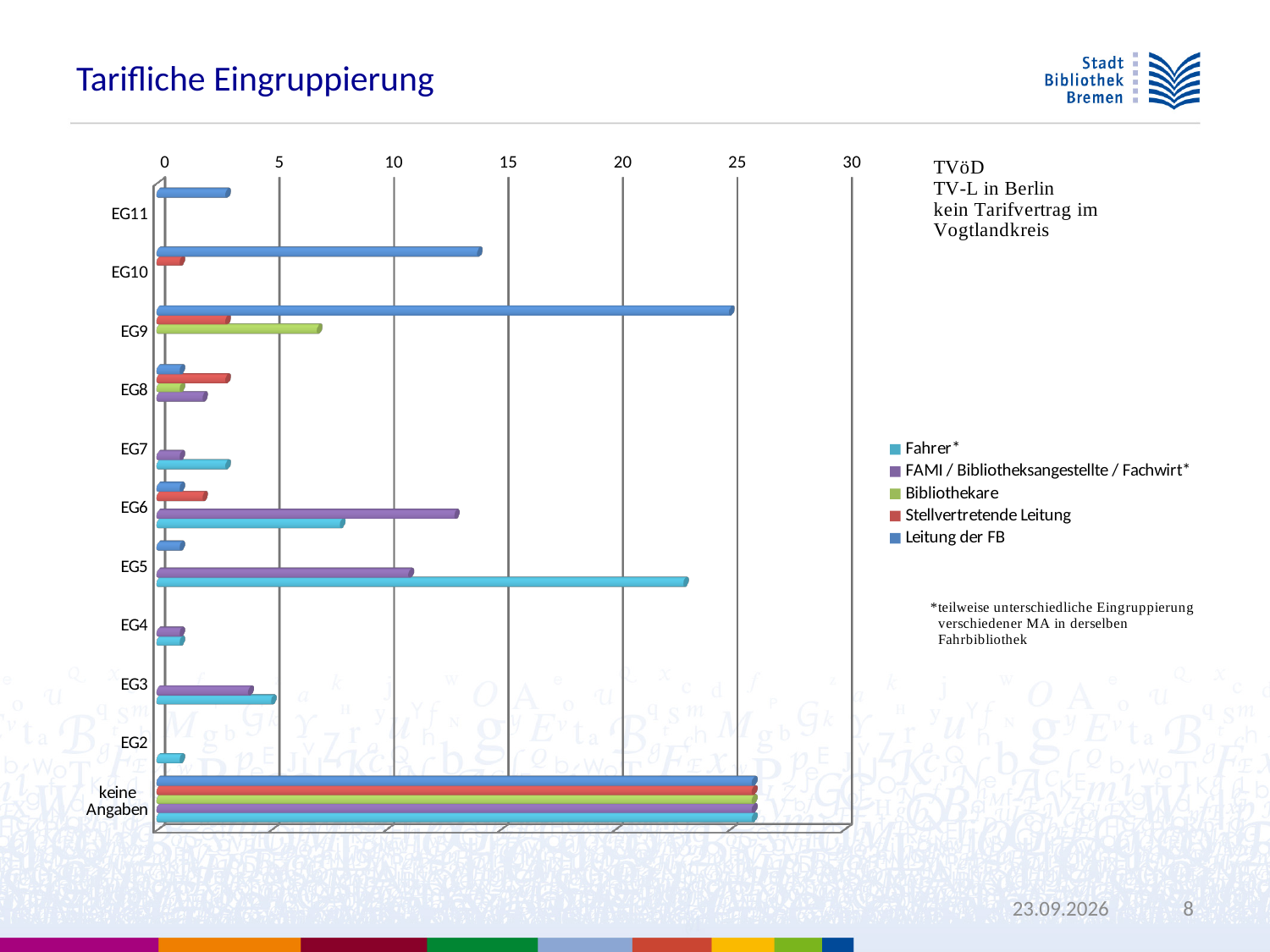
What kind of chart is shown on the slide? bar chart Is the value for FAMI / Bibliotheksangestellte / Fachwirt* in EG6 greater or less than 10? greater How many categories are shown on the vertical axis of the chart? 11 Among the EG categories (excluding 'keine Angaben'), which has the highest value for Leitung der FB? EG9 Is the value for Bibliothekare in EG9 greater or less than 10? less How many series does the chart legend list? 5 For Leitung der FB, which category has the larger value: EG9 or EG10? EG9 Is the value for Leitung der FB in EG10 greater or less than 10? greater In EG5, which series has the larger value: Fahrer* or FAMI / Bibliotheksangestellte / Fachwirt*? Fahrer* What is the title of the slide containing the chart? Tarifliche Eingruppierung